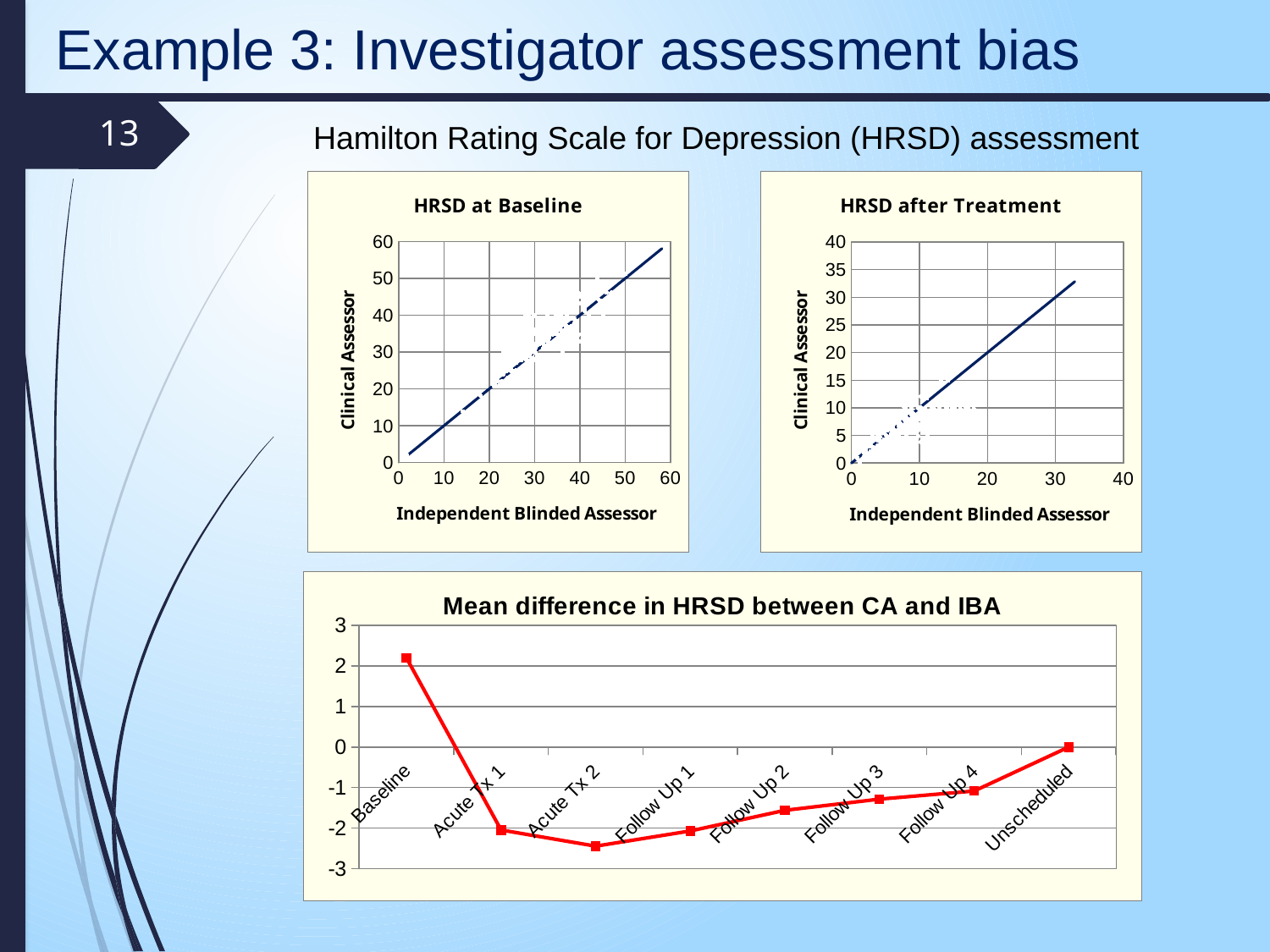
In the 'Mean difference in HRSD between CA and IBA' chart, how many visits (categories) are plotted along the x axis? 8 In the 'HRSD at Baseline' chart, what is the title of the x axis? Independent Blinded Assessor In the 'Mean difference in HRSD between CA and IBA' chart, which visit has the highest mean difference? Baseline In the 'HRSD after Treatment' chart, what is the title of the y axis? Clinical Assessor In the 'Mean difference in HRSD between CA and IBA' chart, which visit has the lowest mean difference? Acute Tx 2 What kind of chart is the 'Mean difference in HRSD between CA and IBA' chart? line chart In the 'Mean difference in HRSD between CA and IBA' chart, do the values rise or fall from Acute Tx 2 to Unscheduled? rise In the 'Mean difference in HRSD between CA and IBA' chart, is the value for Follow Up 3 greater or less than -2? greater In the 'Mean difference in HRSD between CA and IBA' chart, is the value for Baseline greater or less than 1? greater In the 'Mean difference in HRSD between CA and IBA' chart, which is larger, the value for Follow Up 2 or the value for Follow Up 4? Follow Up 4 In the 'Mean difference in HRSD between CA and IBA' chart, which is larger, the value for Baseline or the value for Acute Tx 1? Baseline In the 'Mean difference in HRSD between CA and IBA' chart, is the value for Acute Tx 2 greater or less than -2? less